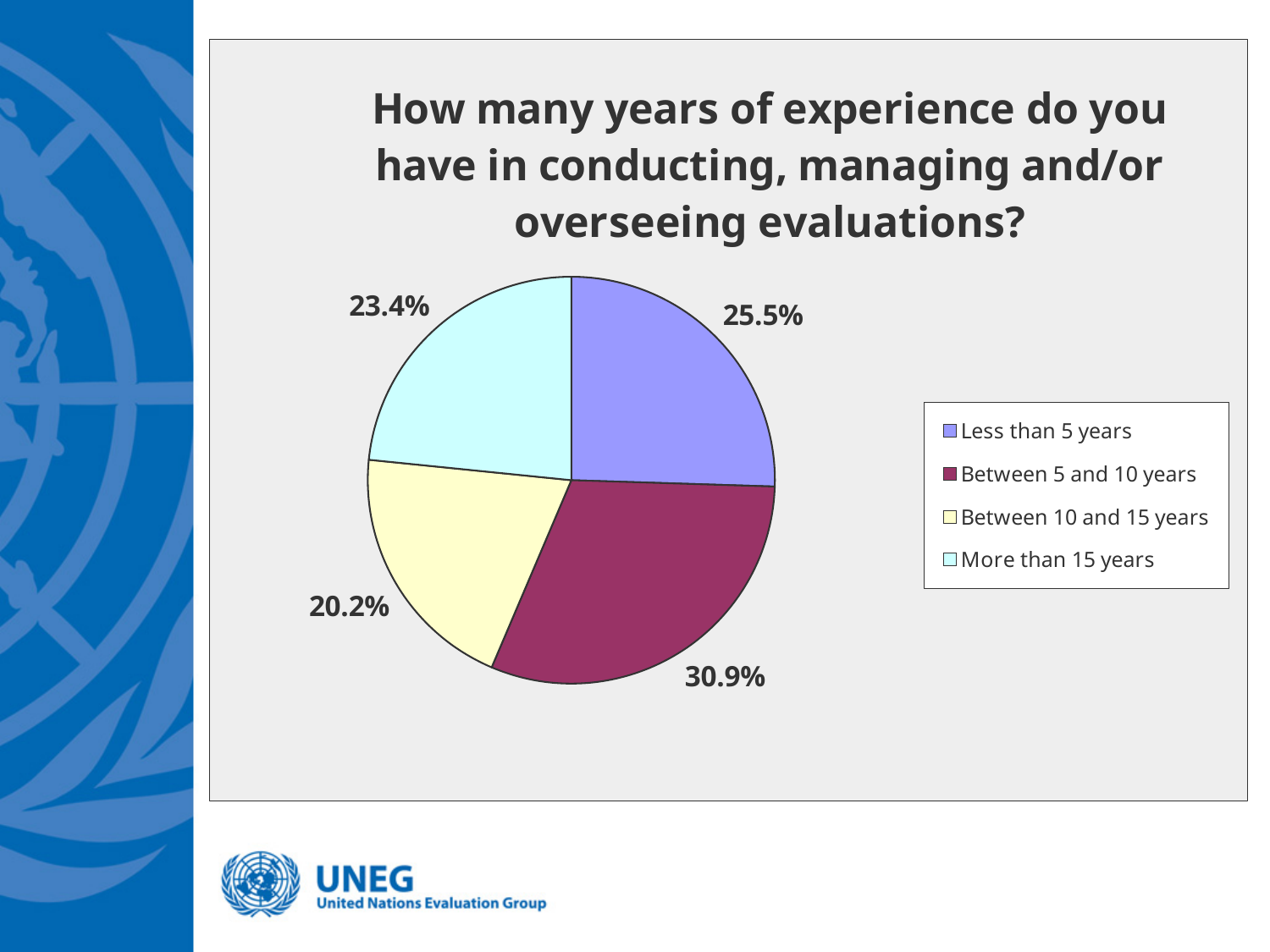
What colour is the slice for 'Between 5 and 10 years'? Dark magenta Which experience category has the largest share? Between 5 and 10 years Which is larger: the share for 'Less than 5 years' or the share for 'More than 15 years'? Less than 5 years Which experience category has the smallest share? Between 10 and 15 years What share of respondents have less than 5 years of experience? 25.5% What share of respondents have more than 15 years of experience? 23.4% What share of respondents have between 10 and 15 years of experience? 20.2% How many categories does the pie chart show? 4 What type of chart is shown on the slide? Pie chart What is the difference in percentage points between the 'Between 5 and 10 years' slice and the 'Between 10 and 15 years' slice? 10.7 What share of respondents have between 5 and 10 years of experience? 30.9% What is the title of the chart? How many years of experience do you have in conducting, managing and/or overseeing evaluations?